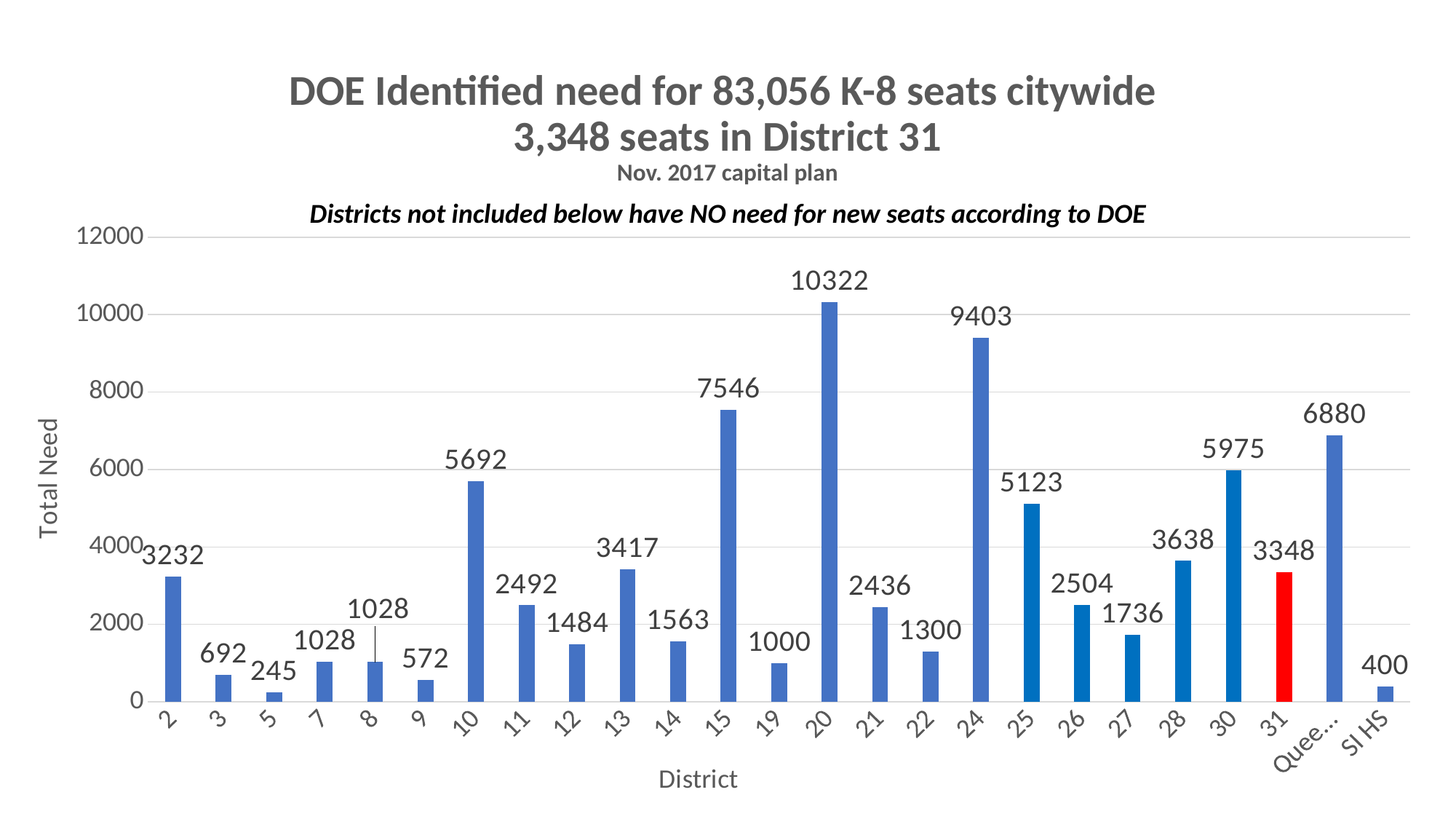
Which district has the lowest Total Need? District 5 Which district's bar is coloured red? District 31 What is the difference in Total Need between District 20 and District 24? 919 Which district has the highest Total Need? District 20 What is the difference in Total Need between District 28 and District 31? 290 How many bars are shown in the chart? 25 What is the Total Need value for SI HS? 400 Which has a larger Total Need, District 15 or District 30? District 15 What kind of chart is shown on the slide? Bar chart Is the value for District 10 greater or less than 6000? less What is the Total Need value for District 31? 3348 What is the Total Need value for District 15? 7546